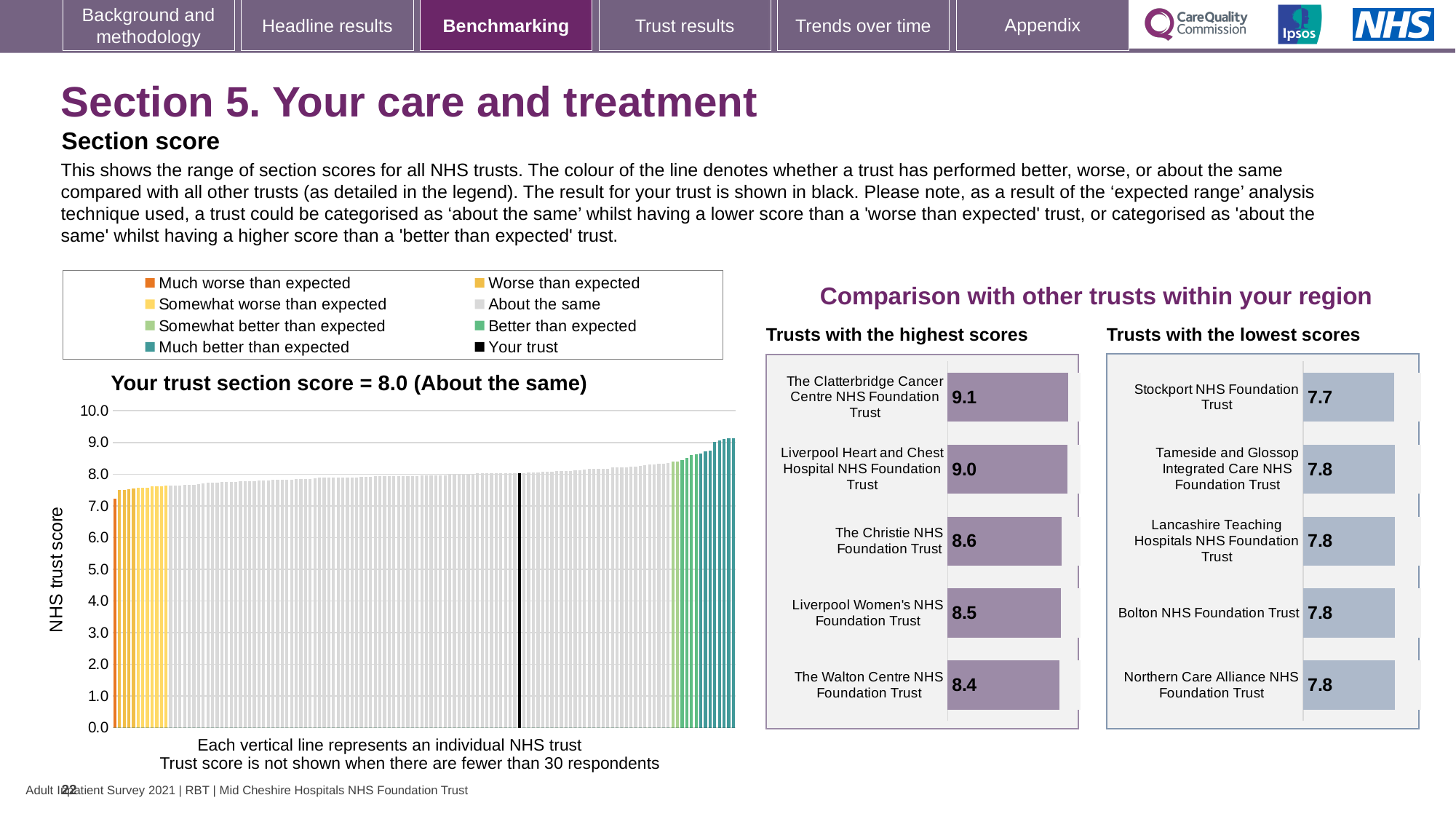
How many trusts are shown on the 'Trusts with the highest scores' chart? 5 On the 'Trusts with the highest scores' chart, what is the score for The Christie NHS Foundation Trust? 8.6 On the 'Your trust section score' chart, what is the section score for your trust? 8.0 On the 'Trusts with the lowest scores' chart, which trust has the lowest score? Stockport NHS Foundation Trust On the 'Trusts with the lowest scores' chart, what is the difference between the scores of Bolton NHS Foundation Trust and Stockport NHS Foundation Trust? 0.1 How many entries does the legend above the 'Your trust section score' chart list? 8 On the 'Trusts with the highest scores' chart, which trust has the lowest score? The Walton Centre NHS Foundation Trust On the 'Your trust section score' chart, what is the label on the vertical axis? NHS trust score On the 'Trusts with the highest scores' chart, which trust has the highest score? The Clatterbridge Cancer Centre NHS Foundation Trust On the 'Trusts with the lowest scores' chart, what is the score for Stockport NHS Foundation Trust? 7.7 What kind of chart is the 'Your trust section score' chart? bar chart On the 'Trusts with the highest scores' chart, what is the difference between the scores of The Clatterbridge Cancer Centre NHS Foundation Trust and The Walton Centre NHS Foundation Trust? 0.7